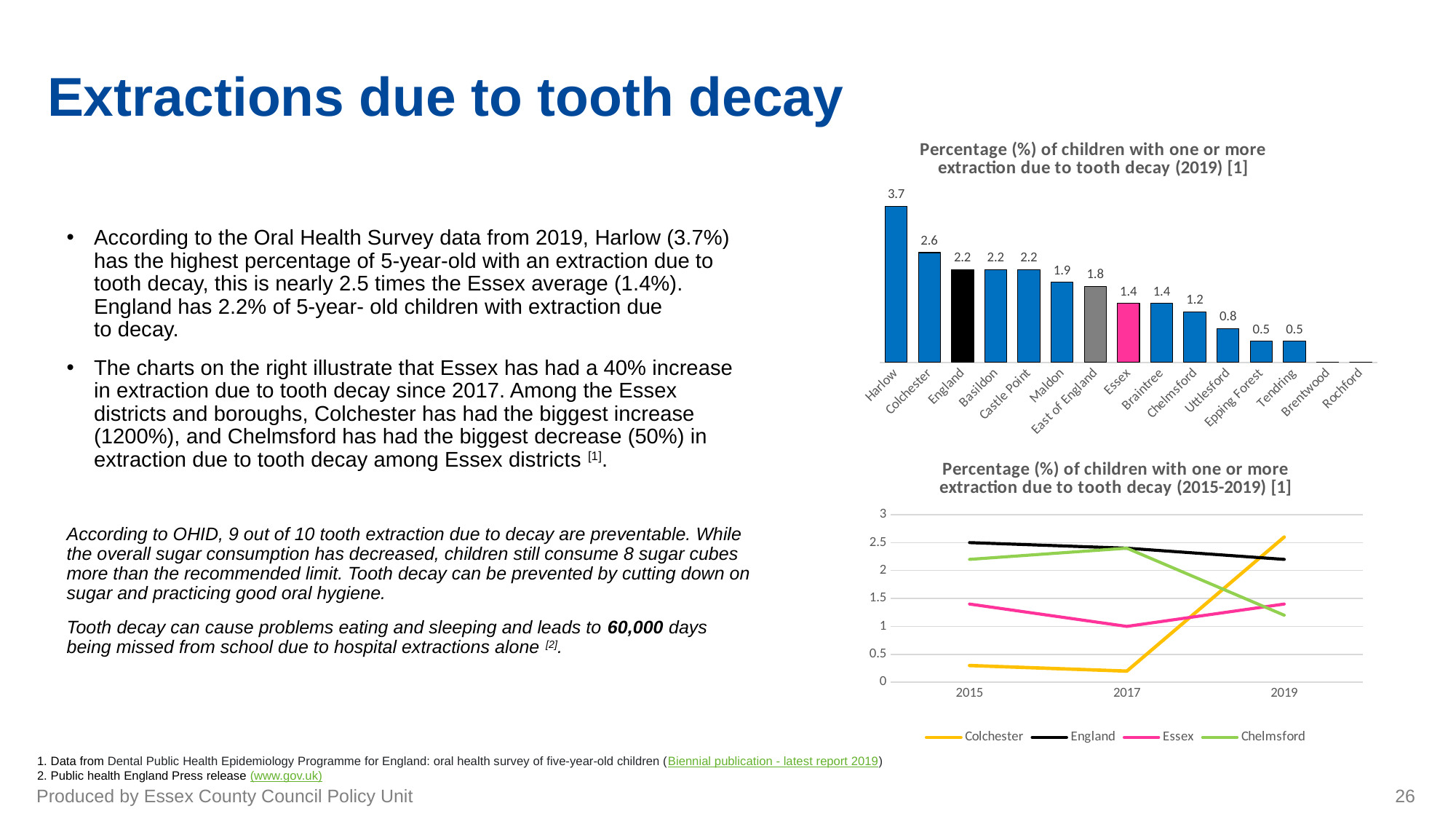
In the 2019 bar chart, what is the value shown for Essex? 1.4 In the bar chart titled 'Percentage (%) of children with one or more extraction due to tooth decay (2019)', what is the value for Harlow? 3.7 In the 2019 bar chart, which area has the highest percentage of children with one or more extraction due to tooth decay? Harlow In the 2015-2019 line chart, is the value for Colchester in 2015 greater or less than 0.5? less In the 2019 bar chart, what is the value shown for Chelmsford? 1.2 How many series does the legend of the 2015-2019 chart list? 4 In the 2019 bar chart, what is the difference between the values for Harlow and Essex? 2.3 How many areas are shown along the x axis of the 2019 bar chart? 15 In the 2015-2019 line chart, does the Colchester line rise or fall between 2017 and 2019? Rise In the 2019 bar chart, which is larger, the value for Colchester or the value for Maldon? Colchester What kind of chart is the bottom chart on the slide (2015-2019 data)? Line chart What kind of chart is the top chart on the slide (2019 data)? Bar chart